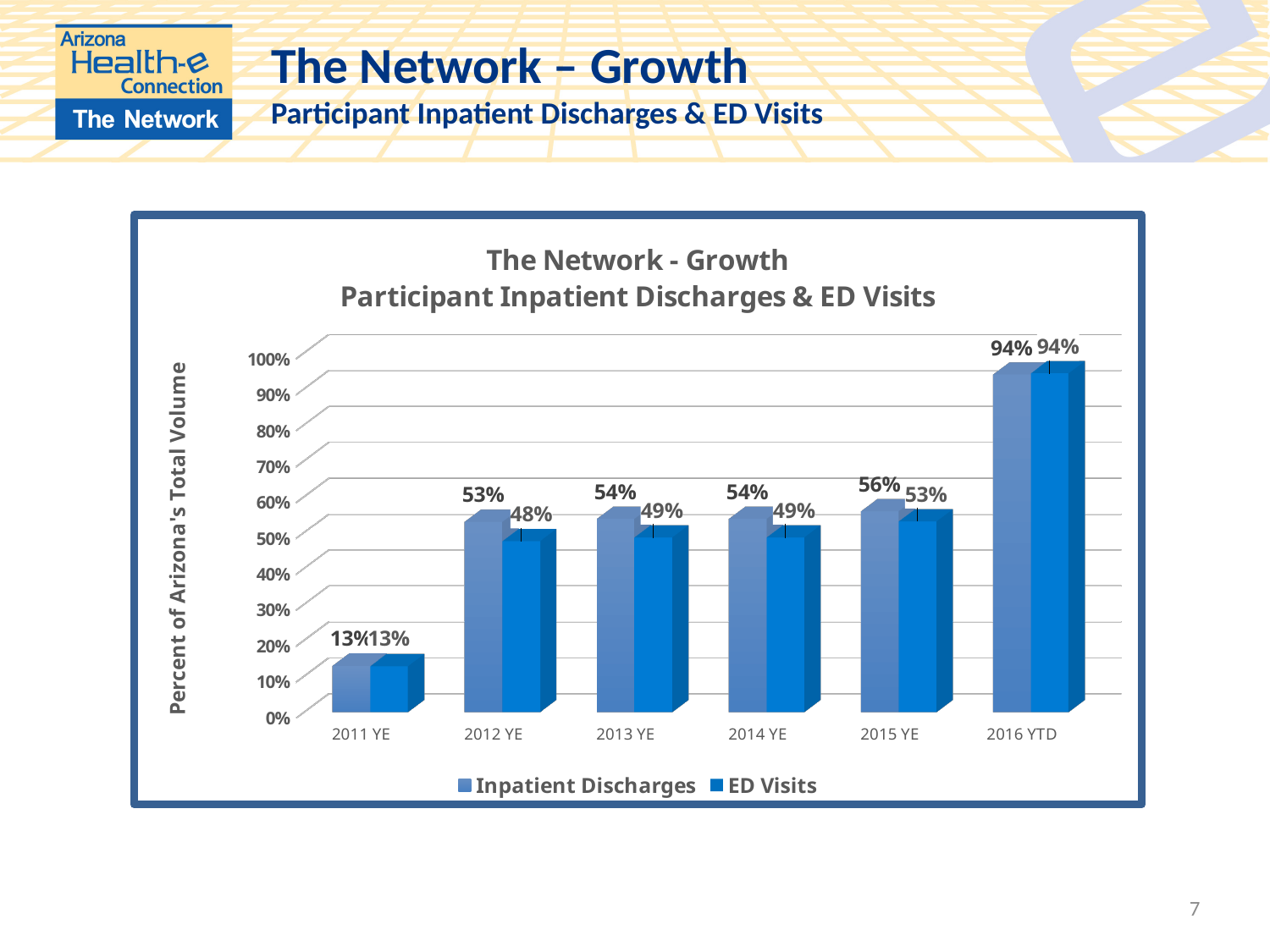
What is the ED Visits value for 2011 YE? 13% What is the difference between the Inpatient Discharges values for 2016 YTD and 2015 YE? 38% Which is larger for 2013 YE: Inpatient Discharges or ED Visits? Inpatient Discharges What is the difference between the Inpatient Discharges and ED Visits values for 2012 YE? 5% How many series does the legend list? 2 Which category has the lowest ED Visits value? 2011 YE How many categories are shown on the x axis? 6 What is the ED Visits value for 2015 YE? 53% Which category has the highest Inpatient Discharges value? 2016 YTD What kind of chart is shown on the slide? Bar chart What is the Inpatient Discharges value for 2012 YE? 53% What is the label of the vertical axis? Percent of Arizona's Total Volume